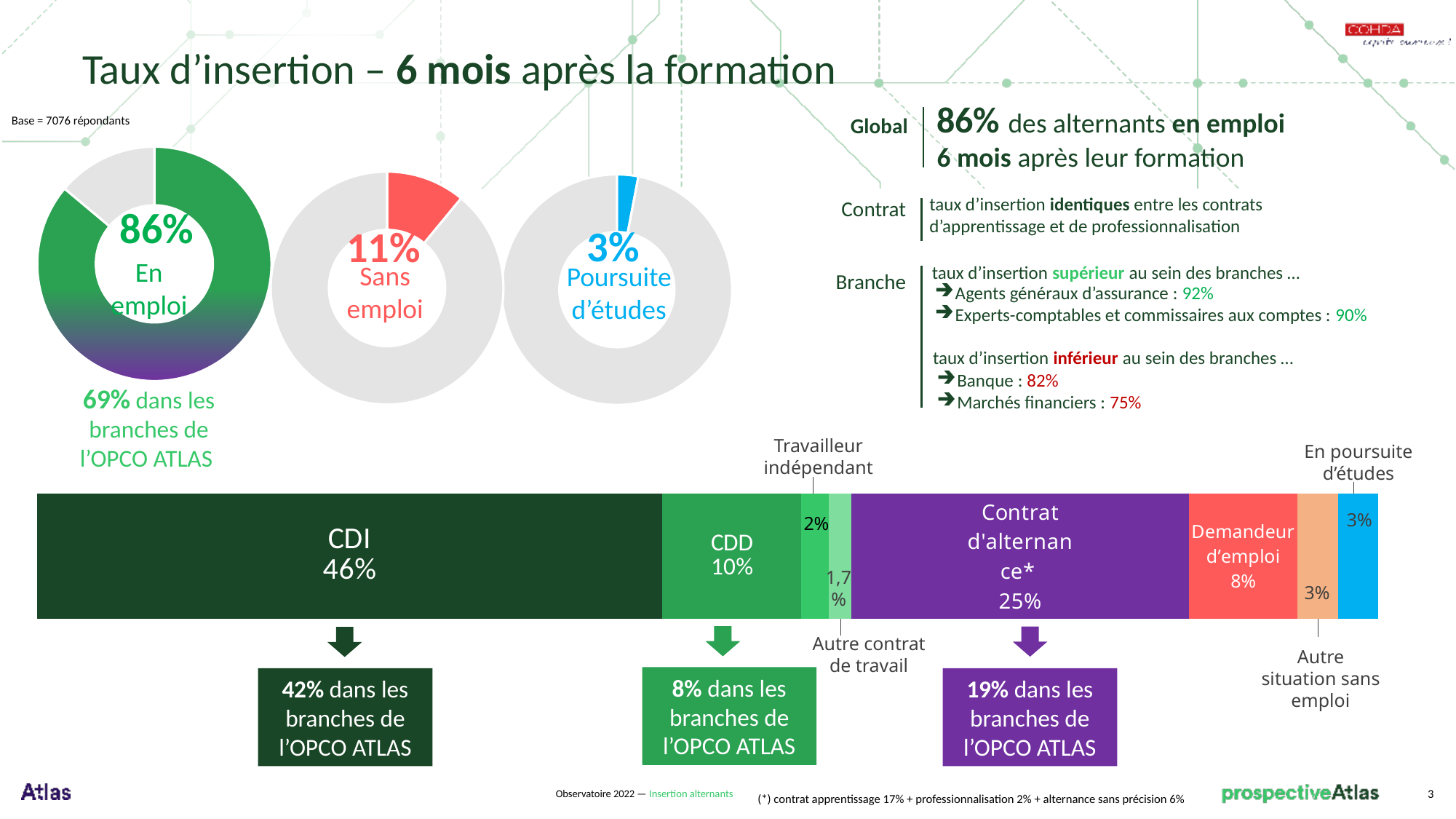
In the stacked bar chart, what percentage is shown for CDI? 46% In the stacked bar chart, which segment has the smallest share? Autre contrat de travail In the stacked bar chart, what percentage is shown for Autre contrat de travail? 1,7% In the stacked bar chart, which is larger: Contrat d'alternance or CDD? Contrat d'alternance In the stacked bar chart, what percentage is shown for Demandeur d'emploi? 8% In the stacked bar chart, what percentage is shown for Contrat d'alternance? 25% In the stacked bar chart, what is the difference between the CDI share and the CDD share? 36% What percentage does the 'Sans emploi' donut chart show? 11% How many segments does the stacked bar chart contain? 8 In the stacked bar chart, which segment has the largest share? CDI What percentage does the 'Poursuite d'études' donut chart show? 3% What type of chart is used to show the 'En emploi' 86% figure? Donut chart